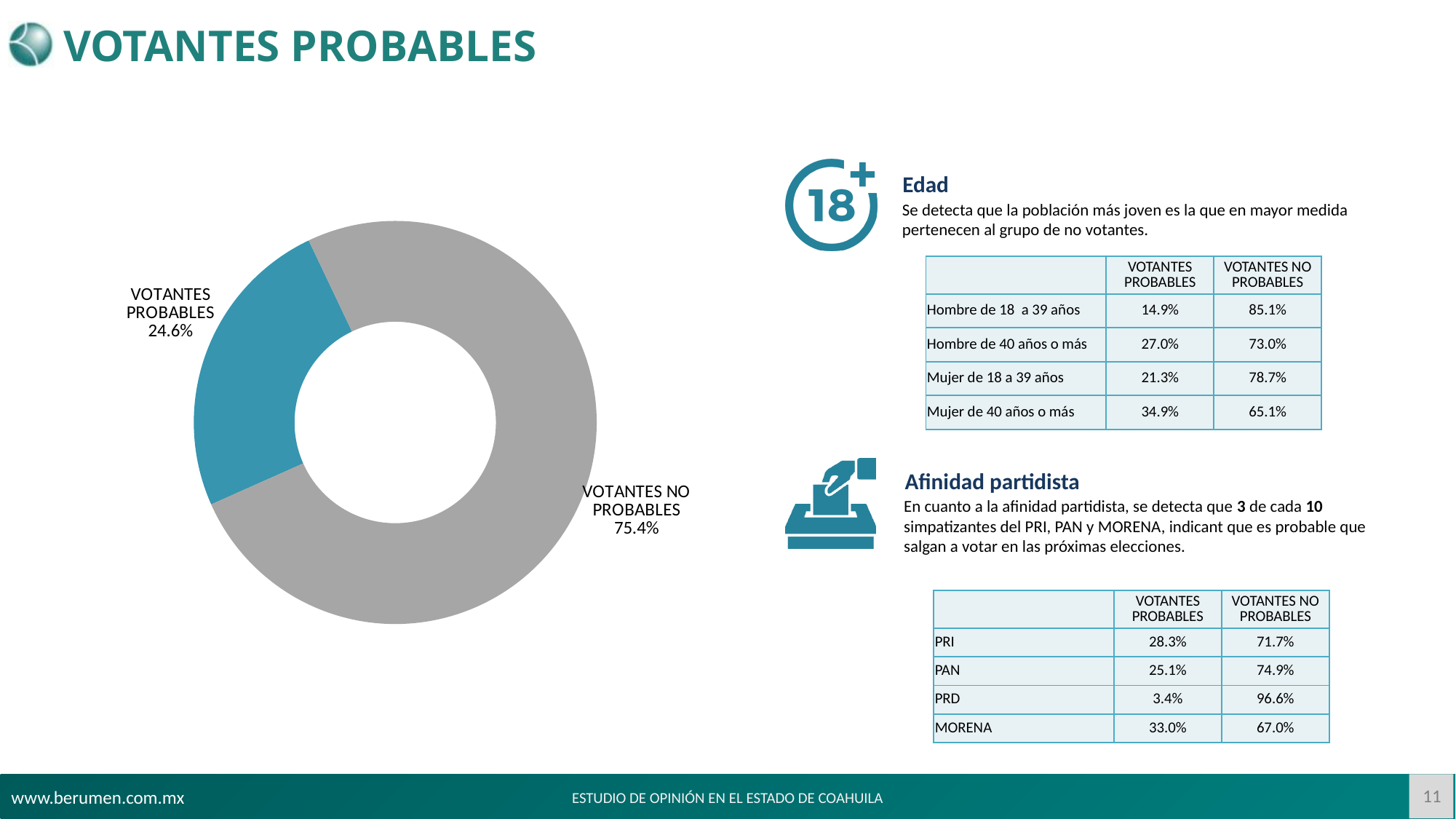
What kind of chart is shown on the left of the slide? Donut (pie) chart In the donut chart, which is larger: VOTANTES PROBABLES or VOTANTES NO PROBABLES? VOTANTES NO PROBABLES What colour is the VOTANTES PROBABLES slice in the donut chart? Teal blue What share of the donut chart is labelled VOTANTES NO PROBABLES? 75.4% Which slice of the donut chart is the largest? VOTANTES NO PROBABLES What colour is the VOTANTES NO PROBABLES slice in the donut chart? Grey What share of the donut chart is labelled VOTANTES PROBABLES? 24.6% Is the share for VOTANTES NO PROBABLES in the donut chart greater or less than 50%? greater How many slices does the donut chart have? 2 By how many percentage points does VOTANTES NO PROBABLES exceed VOTANTES PROBABLES in the donut chart? 50.8 percentage points Which slice of the donut chart is the smallest? VOTANTES PROBABLES What do the two slices of the donut chart add up to? 100%